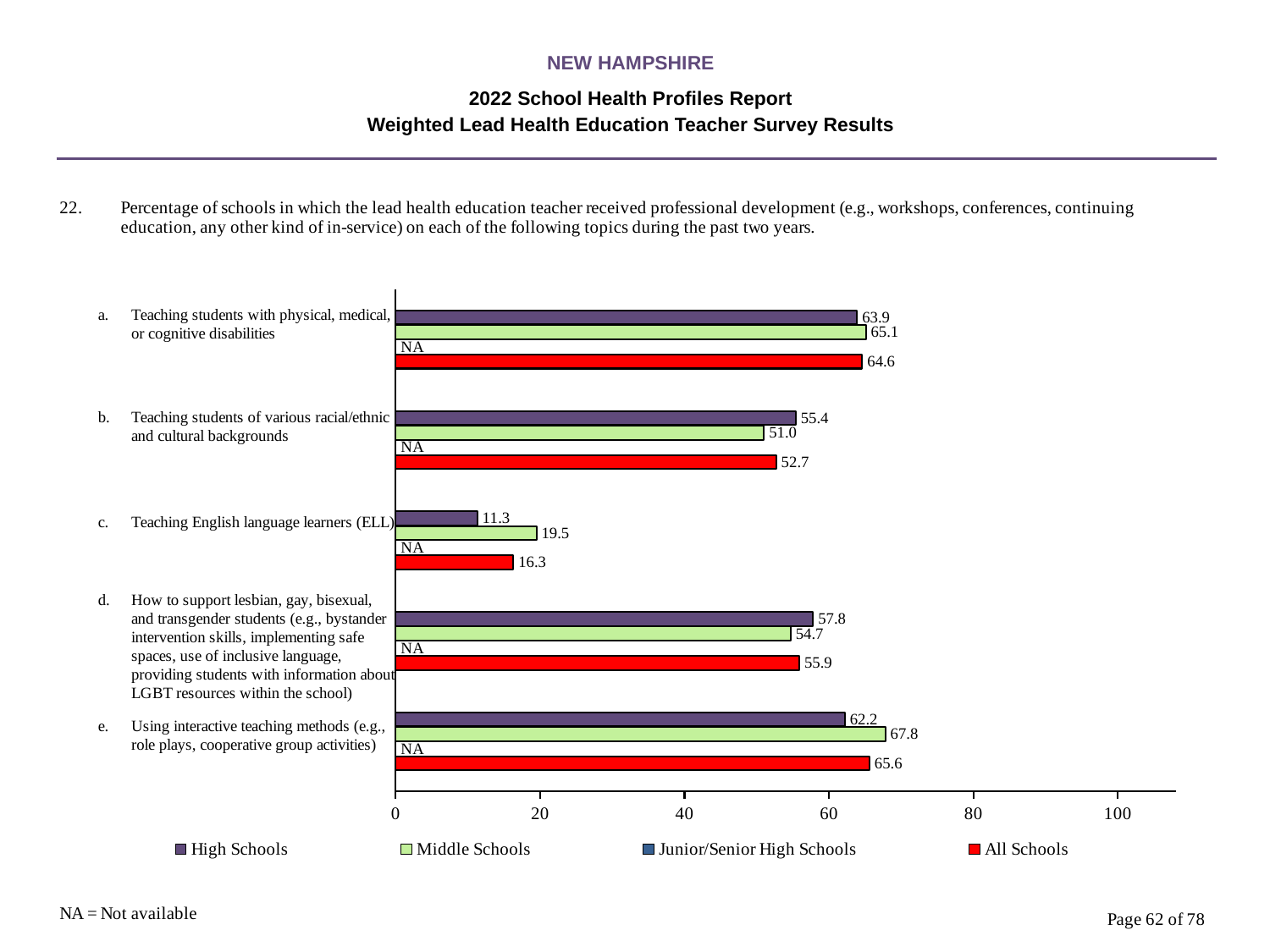
What is the All Schools value for 'Using interactive teaching methods (e.g., role plays, cooperative group activities)'? 65.6 What kind of chart is shown on the slide? bar chart For 'Teaching students of various racial/ethnic and cultural backgrounds', which is larger: the High Schools value or the Middle Schools value? High Schools Which topic has the highest Middle Schools value? Using interactive teaching methods (e.g., role plays, cooperative group activities) Is the All Schools value for 'How to support lesbian, gay, bisexual, and transgender students' greater or less than 40? greater How many series does the legend list? 4 Which topic has the lowest All Schools value? Teaching English language learners (ELL) What is the difference between the Middle Schools and High Schools values for 'Teaching English language learners (ELL)'? 8.2 What is the value for Middle Schools for 'Teaching English language learners (ELL)'? 19.5 What is the value for High Schools for 'Teaching students with physical, medical, or cognitive disabilities'? 63.9 How many topics (categories) are shown in the chart? 5 What is shown for Junior/Senior High Schools for 'Teaching students of various racial/ethnic and cultural backgrounds'? NA